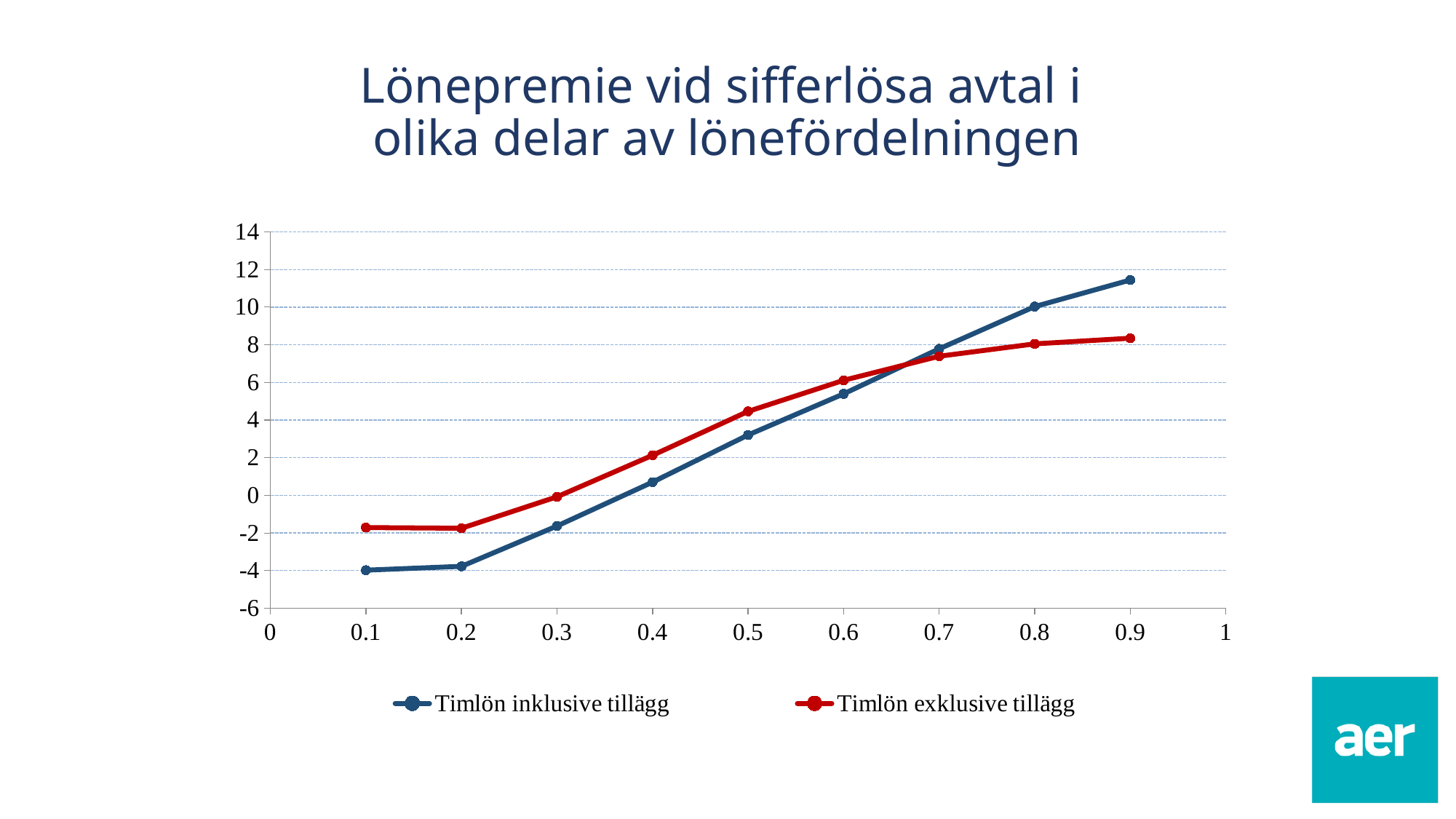
Does the 'Timlön inklusive tillägg' series rise or fall as the x value increases from 0.1 to 0.9? rise Is the value for 'Timlön inklusive tillägg' at 0.1 greater or less than -2? less Is the value for 'Timlön inklusive tillägg' at 0.5 greater or less than 2? greater Is the value for 'Timlön exklusive tillägg' at 0.9 greater or less than 10? less How many series does the legend list? 2 How many data points does the 'Timlön inklusive tillägg' series have? 9 What is the title of the chart? Lönepremie vid sifferlösa avtal i olika delar av lönefördelningen At x = 0.3, which series has the higher value? Timlön exklusive tillägg What kind of chart is shown on the slide? line chart At which x value does the 'Timlön inklusive tillägg' series reach its highest value? 0.9 At x = 0.9, which series has the higher value? Timlön inklusive tillägg